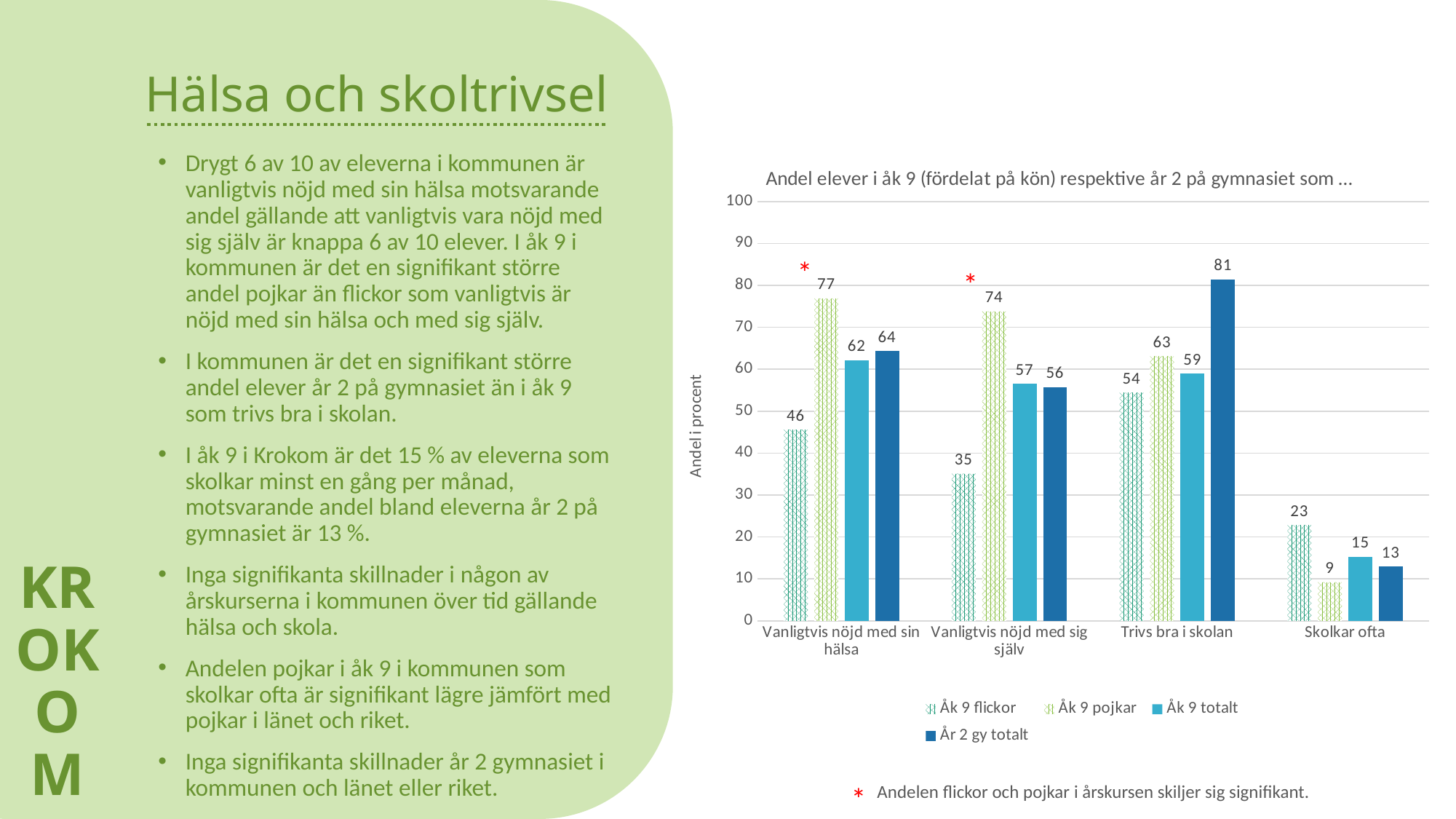
How many categories are shown on the x axis? 4 What is the difference between Åk 9 pojkar and Åk 9 flickor in the 'Vanligtvis nöjd med sig själv' category? 39 What is the value for Åk 9 flickor in the 'Skolkar ofta' category? 23 What is the value for Åk 9 totalt in the 'Vanligtvis nöjd med sig själv' category? 57 What kind of chart is shown on the slide? Bar chart What is the value for År 2 gy totalt in the 'Trivs bra i skolan' category? 81 What is the value for Åk 9 pojkar in the 'Vanligtvis nöjd med sin hälsa' category? 77 Which is larger in the 'Trivs bra i skolan' category: Åk 9 flickor or Åk 9 pojkar? Åk 9 pojkar How many series does the legend list? 4 Which category has the lowest value for Åk 9 pojkar? Skolkar ofta Which category has the highest value for År 2 gy totalt? Trivs bra i skolan What is the label of the vertical axis? Andel i procent